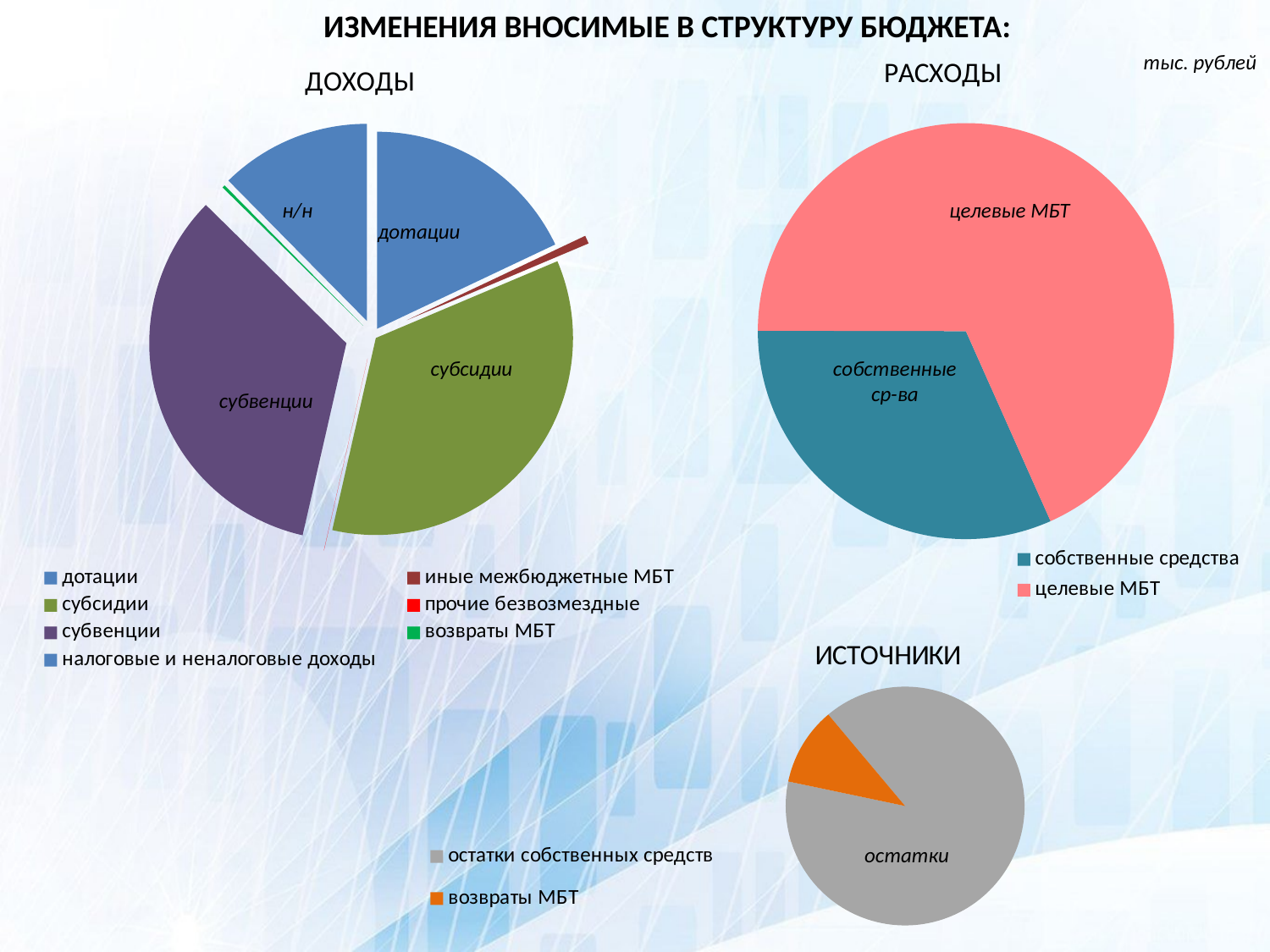
What kind of chart is the РАСХОДЫ chart? pie chart In the ИСТОЧНИКИ chart, which category has the smallest slice? возвраты МБТ In the ДОХОДЫ chart, what colour is the субсидии slice? green In the РАСХОДЫ chart, is the share of целевые МБТ greater or less than 50%? greater In the РАСХОДЫ chart, which category has the largest slice? целевые МБТ In the ИСТОЧНИКИ chart, which category has the largest slice? остатки собственных средств In the ДОХОДЫ chart, which is larger: дотации or субсидии? субсидии How many categories does the legend of the ДОХОДЫ chart list? 7 How many categories does the legend of the РАСХОДЫ chart list? 2 In the ДОХОДЫ chart, which is larger: н/н or субвенции? субвенции What kind of chart is the ДОХОДЫ chart? pie chart How many pie charts are shown on the slide? 3